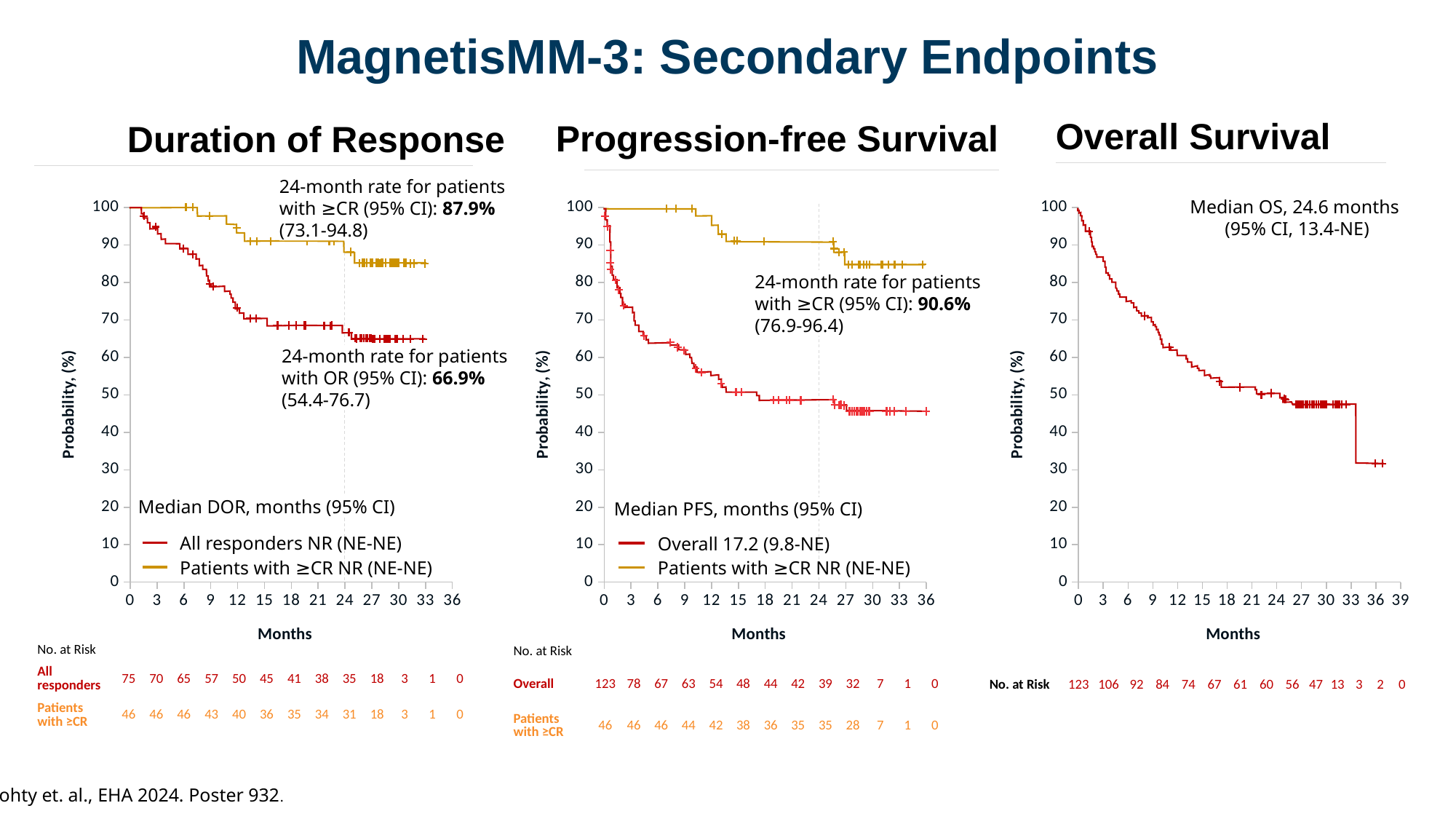
On the Overall Survival chart, does the probability rise or fall as months increase? Fall On the Duration of Response chart, at 24 months, which curve is higher: All responders or Patients with ≥CR? Patients with ≥CR On the Duration of Response chart, what is the 24-month rate for patients with ≥CR? 87.9% On the Overall Survival chart, how many patients were at risk at month 0? 123 On the Duration of Response chart, what is the 24-month rate for patients with OR? 66.9% What kind of chart is the Overall Survival chart? Line chart (Kaplan-Meier survival curve) On the Progression-free Survival chart, is the Overall curve at 12 months greater or less than 50? greater On the Duration of Response chart, how many patients with ≥CR were at risk at month 24? 31 On the Progression-free Survival chart, how many series does the legend list? 2 On the Progression-free Survival chart, what is the 24-month rate for patients with ≥CR? 90.6% On the Overall Survival chart, what is the median OS? 24.6 months On the Progression-free Survival chart, what is the median PFS in months for the Overall group? 17.2 (9.8-NE)